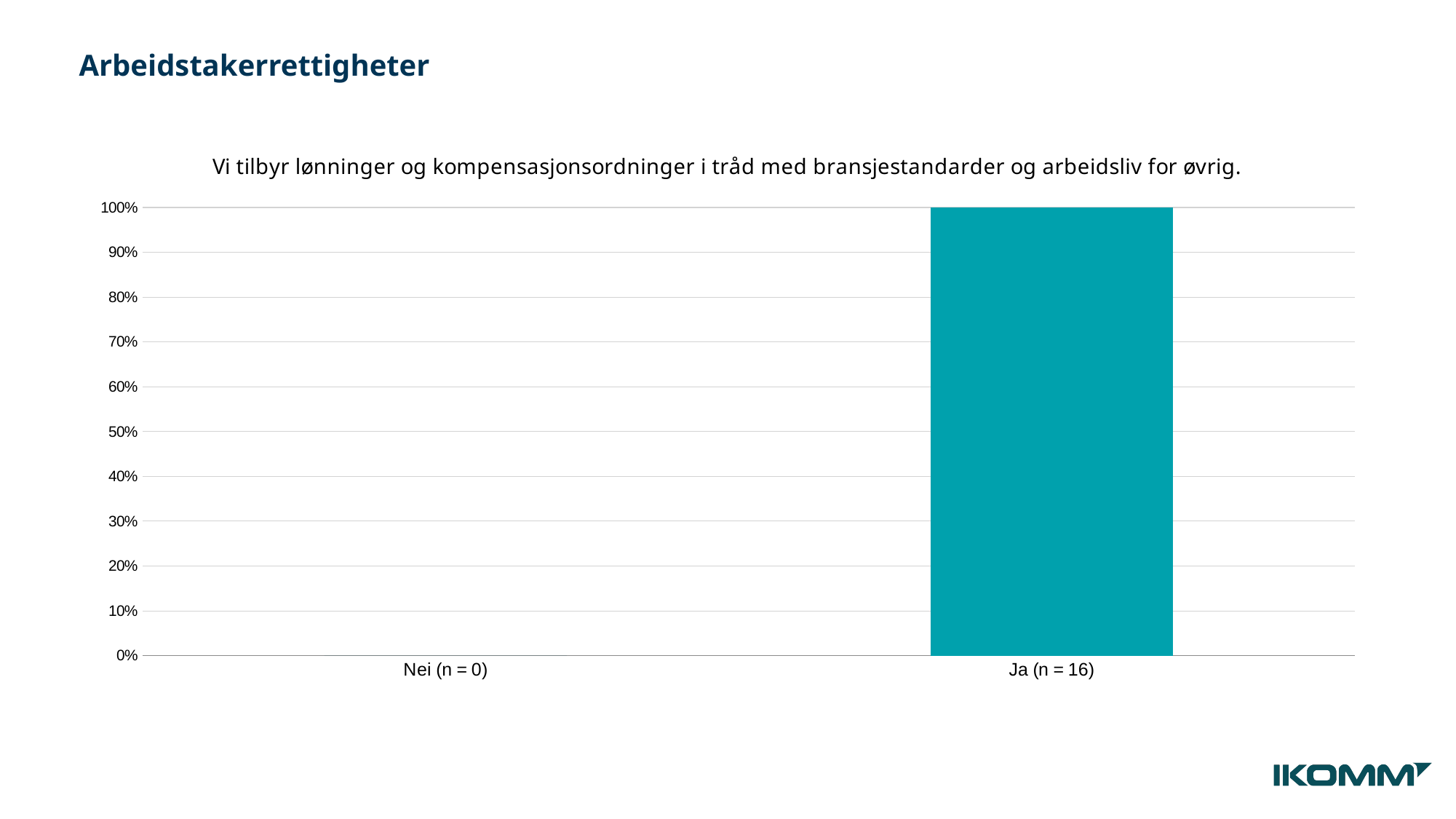
Which is larger, the value for "Ja (n = 16)" or the value for "Nei (n = 0)"? Ja (n = 16) How many respondents answered "Ja" according to the category label? 16 What is the value for "Ja (n = 16)"? 100% Which category has the highest value? Ja (n = 16) What is the maximum value shown on the y axis? 100% What kind of chart is shown on the slide? bar chart Which category has the lowest value? Nei (n = 0) What is the difference between the value for "Ja (n = 16)" and the value for "Nei (n = 0)"? 100% How many categories are shown on the x axis of the chart? 2 Is the value for "Ja (n = 16)" greater or less than 50%? greater What is the title of the chart? Vi tilbyr lønninger og kompensasjonsordninger i tråd med bransjestandarder og arbeidsliv for øvrig. What is the value for "Nei (n = 0)"? 0%